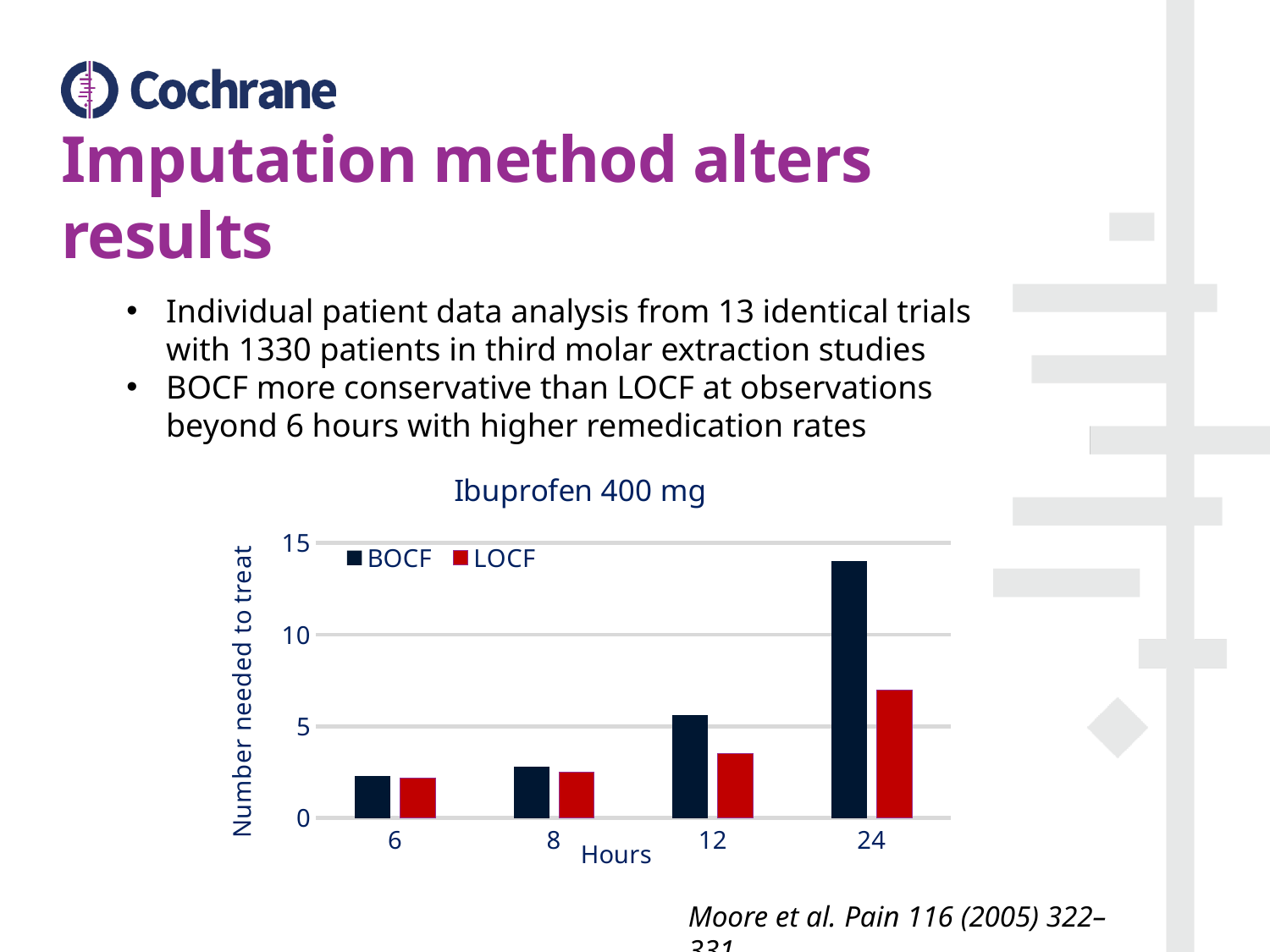
At 12 hours, which series has the larger value, BOCF or LOCF? BOCF At 24 hours, which series has the larger value, BOCF or LOCF? BOCF Do the BOCF values rise or fall as the hours increase along the x axis? rise Is the BOCF value at 24 hours greater or less than 10? greater Is the LOCF value at 24 hours greater or less than 10? less At which hour is the BOCF value highest? 24 How many series does the chart's legend list? 2 At which hour is the LOCF value highest? 24 What is the title of the chart? Ibuprofen 400 mg What is the label of the vertical axis of the chart? Number needed to treat How many hour categories are shown on the x axis of the chart? 4 What kind of chart is shown on the slide? bar chart